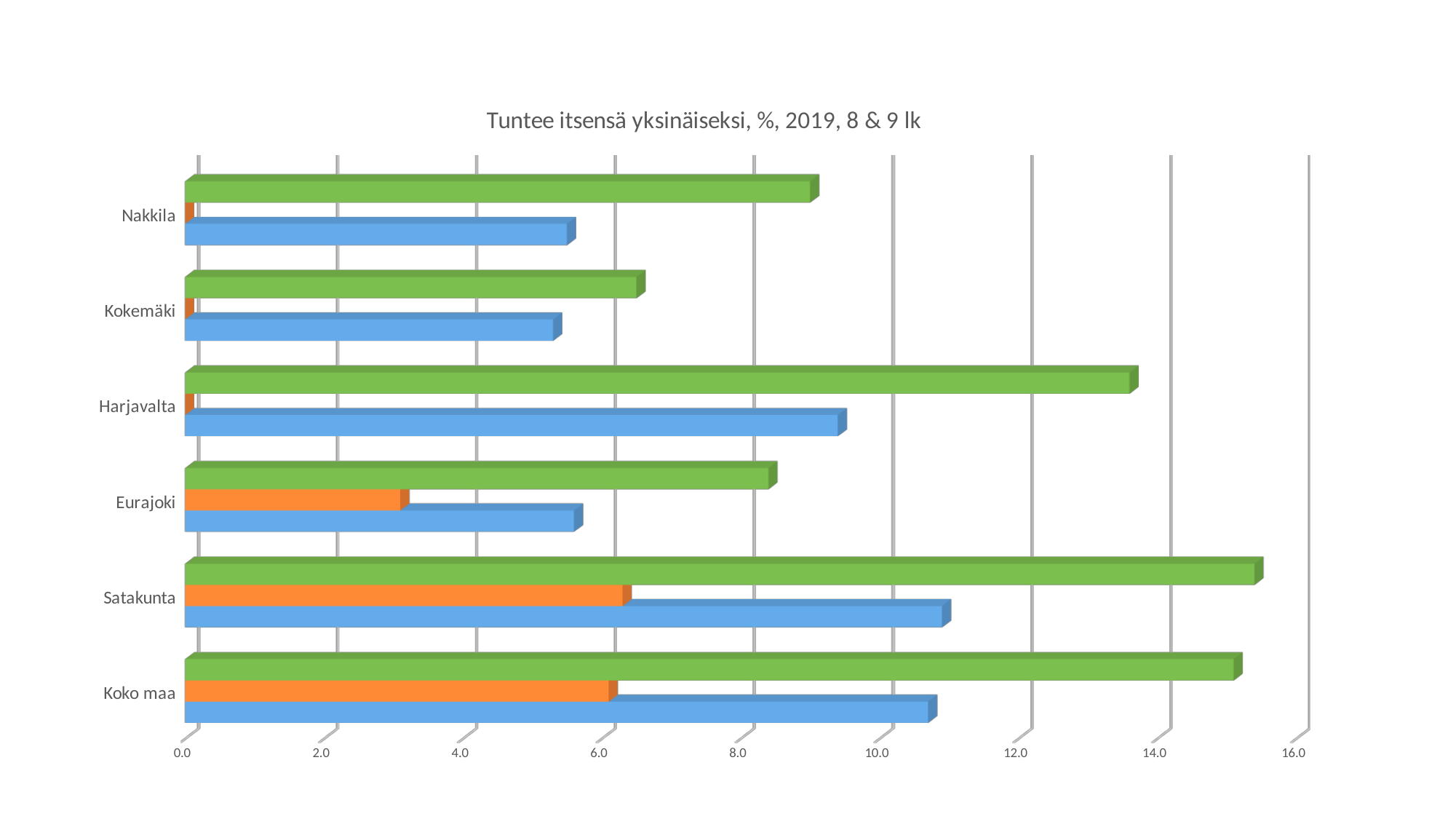
Is the value of the blue bar for Nakkila greater or less than 6.0? less What is the title of the chart? Tuntee itsensä yksinäiseksi, %, 2019, 8 & 9 lk Which is larger, the blue bar for Harjavalta or the blue bar for Kokemäki? Harjavalta Is the value of the green bar for Harjavalta greater or less than 12.0? greater What kind of chart is shown on the slide? bar chart Is the value of the green bar for Nakkila greater or less than 8.0? greater Which category has the shortest green bar? Kokemäki Which is larger, the green bar for Harjavalta or the green bar for Eurajoki? Harjavalta How many categories are shown on the vertical axis of the chart? 6